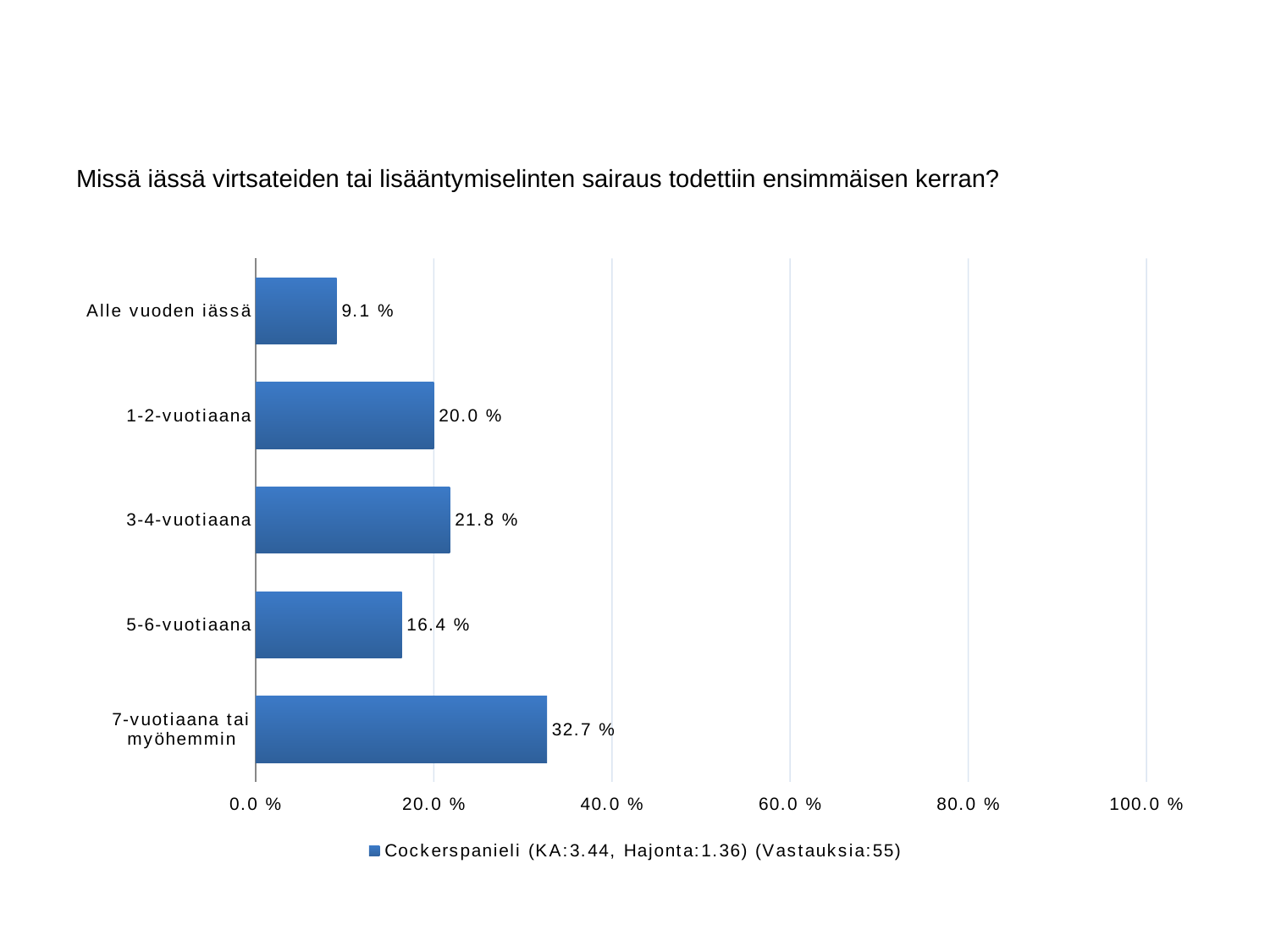
Which category has the lowest value? Alle vuoden iässä What is the value for "3-4-vuotiaana"? 21.8 % What is the difference between the values for "7-vuotiaana tai myöhemmin" and "1-2-vuotiaana"? 12.7 % How many categories are shown in the chart? 5 How many responses (Vastauksia) does the legend entry report? 55 How many series does the legend list? 1 Is the value for "7-vuotiaana tai myöhemmin" greater or less than 40.0 %? less What is the value for "Alle vuoden iässä"? 9.1 % Which is larger, the value for "5-6-vuotiaana" or the value for "1-2-vuotiaana"? 1-2-vuotiaana What is the value for "7-vuotiaana tai myöhemmin"? 32.7 % Which category has the highest value? 7-vuotiaana tai myöhemmin What kind of chart is shown on the slide? bar chart